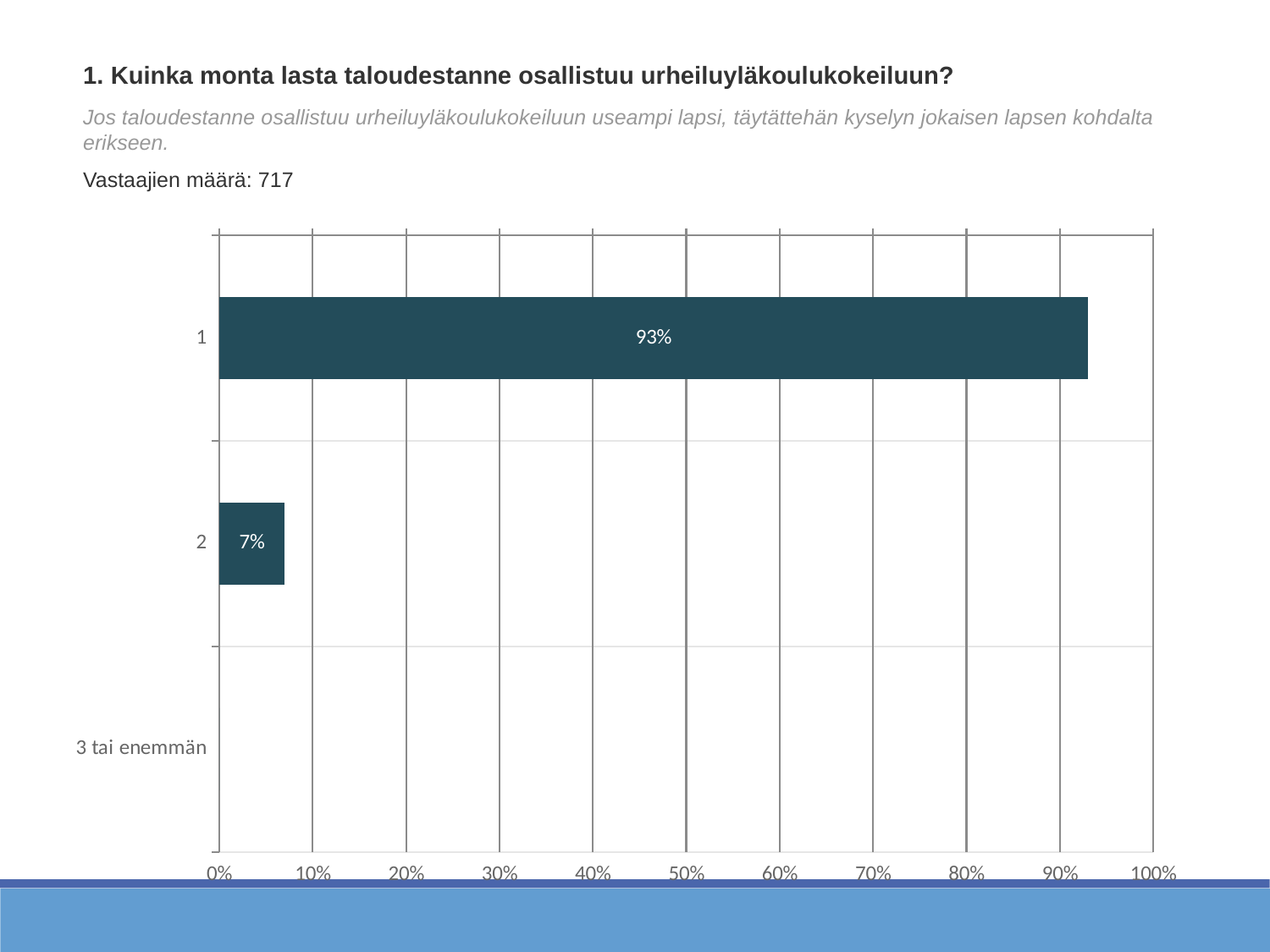
What kind of chart is shown on the slide? bar chart What is the value for category "2"? 7% How many categories are shown on the y axis? 3 What is the maximum value shown on the x axis? 100% How many respondents (Vastaajien määrä) are reported on the slide? 717 What is the value for category "1"? 93% Which category has the highest value? 1 What is the difference between the values for categories "1" and "2"? 86% Is the value for category "2" greater or less than 10%? less What is the label of the third category on the y axis? 3 tai enemmän Is the value for category "1" greater or less than 90%? greater Which is larger, the value for category "1" or category "2"? 1